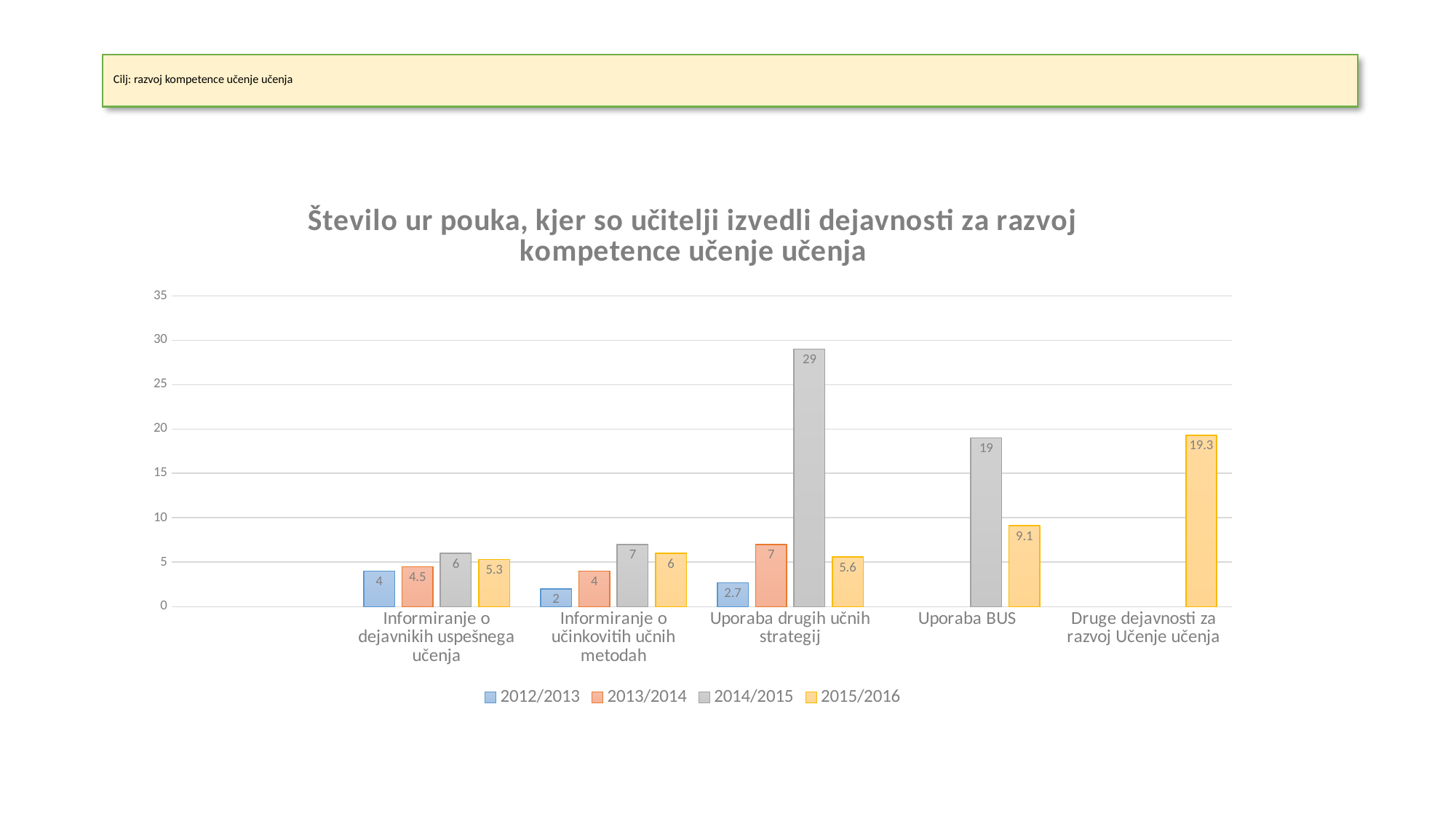
What is the value for 2015/2016 in the 'Uporaba BUS' category? 9.1 What is the value for 2012/2013 in the 'Informiranje o učinkovitih učnih metodah' category? 2 Is the value for 2014/2015 in the 'Uporaba drugih učnih strategij' category greater or less than 25? greater What is the value for 2014/2015 in the 'Uporaba drugih učnih strategij' category? 29 What is the difference between the 2014/2015 and 2015/2016 values in the 'Uporaba BUS' category? 9.9 Which category has the lowest value for the 2012/2013 series? Informiranje o učinkovitih učnih metodah Which is larger in the 'Informiranje o dejavnikih uspešnega učenja' category: the 2013/2014 value or the 2015/2016 value? 2015/2016 How many categories are shown on the x axis? 5 What kind of chart is shown on the slide? bar chart What is the value for 2015/2016 in the 'Druge dejavnosti za razvoj Učenje učenja' category? 19.3 How many series does the legend list? 4 Which category has the highest value for the 2014/2015 series? Uporaba drugih učnih strategij